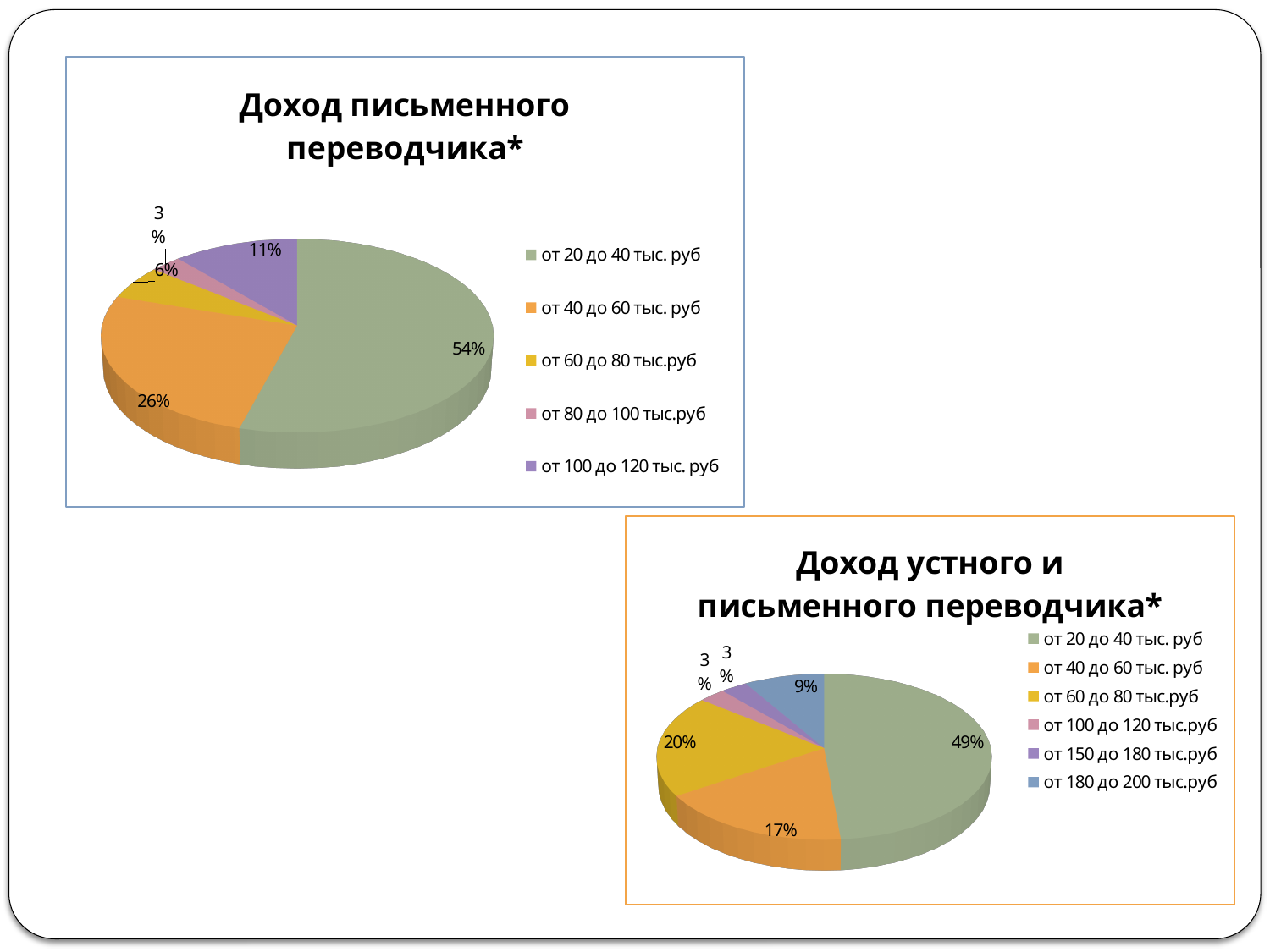
In the chart titled "Доход устного и письменного переводчика*", what share is labelled for the slice "от 60 до 80 тыс.руб"? 20% In the chart titled "Доход письменного переводчика*", what is the difference in percentage points between the "от 20 до 40 тыс. руб" slice and the "от 40 до 60 тыс. руб" slice? 28 In the chart titled "Доход письменного переводчика*", what share is labelled for the slice "от 40 до 60 тыс. руб"? 26% In the chart titled "Доход письменного переводчика*", what share is labelled for the slice "от 20 до 40 тыс. руб"? 54% In the chart titled "Доход письменного переводчика*", which category has the smallest slice? от 80 до 100 тыс.руб In the chart titled "Доход письменного переводчика*", how many categories does the legend list? 5 In the chart titled "Доход устного и письменного переводчика*", which slice is larger: "от 40 до 60 тыс. руб" or "от 60 до 80 тыс.руб"? от 60 до 80 тыс.руб In the chart titled "Доход устного и письменного переводчика*", what share is labelled for the slice "от 180 до 200 тыс.руб"? 9% What kind of chart is the chart titled "Доход устного и письменного переводчика*"? pie chart In the chart titled "Доход устного и письменного переводчика*", how many categories does the legend list? 6 In the chart titled "Доход устного и письменного переводчика*", which category has the largest slice? от 20 до 40 тыс. руб In the chart titled "Доход письменного переводчика*", what colour is the slice for "от 100 до 120 тыс. руб"? purple